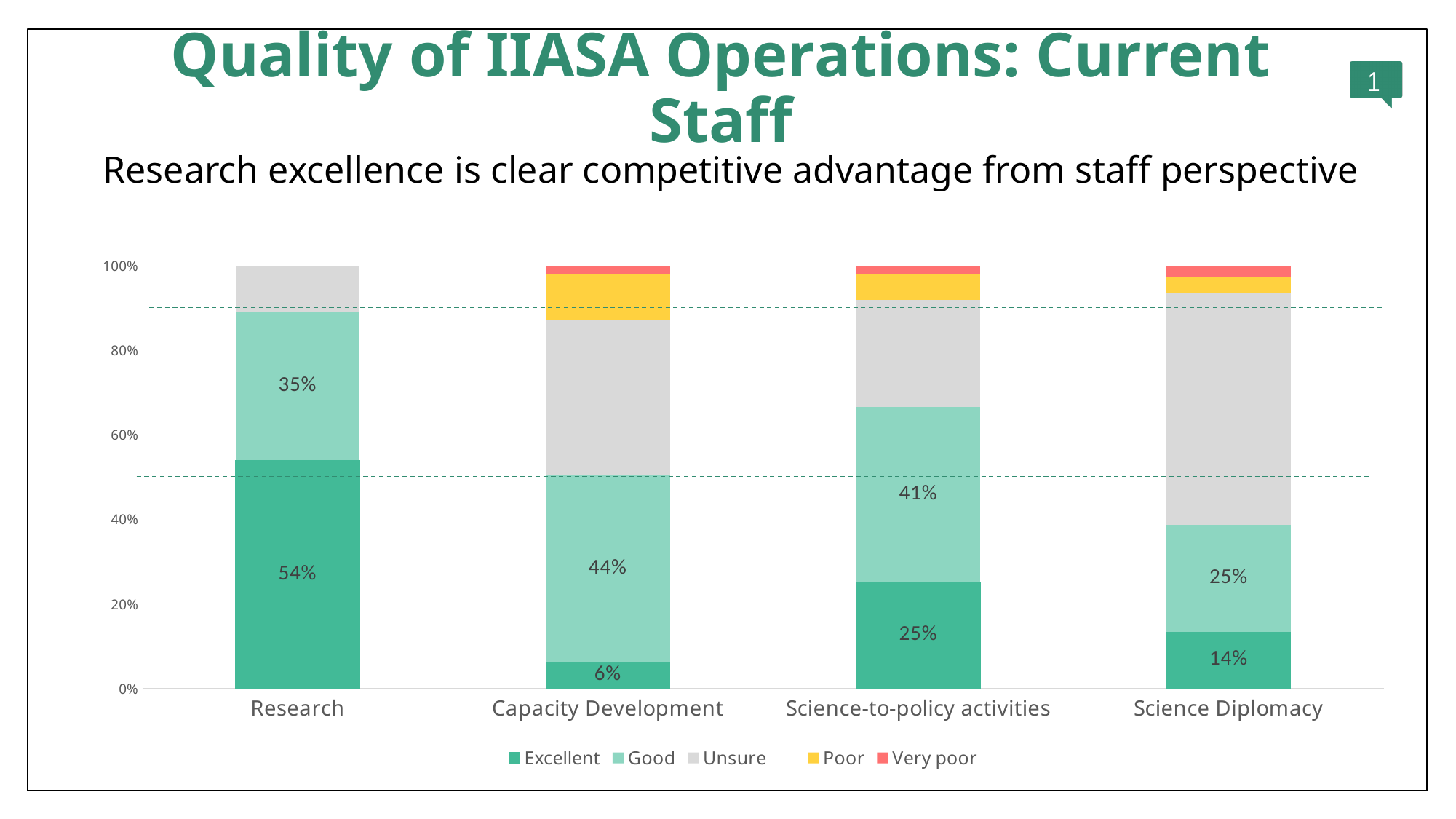
What is the Good share for Capacity Development? 44% Which category has the highest Excellent share? Research What kind of chart is shown on the slide? Stacked bar chart How many percentage points higher is the Good share than the Excellent share for Capacity Development? 38 How many series does the legend list? 5 Which is larger for Science-to-policy activities: the Excellent share or the Good share? Good What percentage rated Science Diplomacy as Excellent? 14% How many categories are shown on the x axis? 4 Which category has the lowest Excellent share? Capacity Development Is the Unsure share for Science Diplomacy greater or less than 40%? greater What percentage of staff rated Research as Excellent? 54% What is the Good value for Science-to-policy activities? 41%